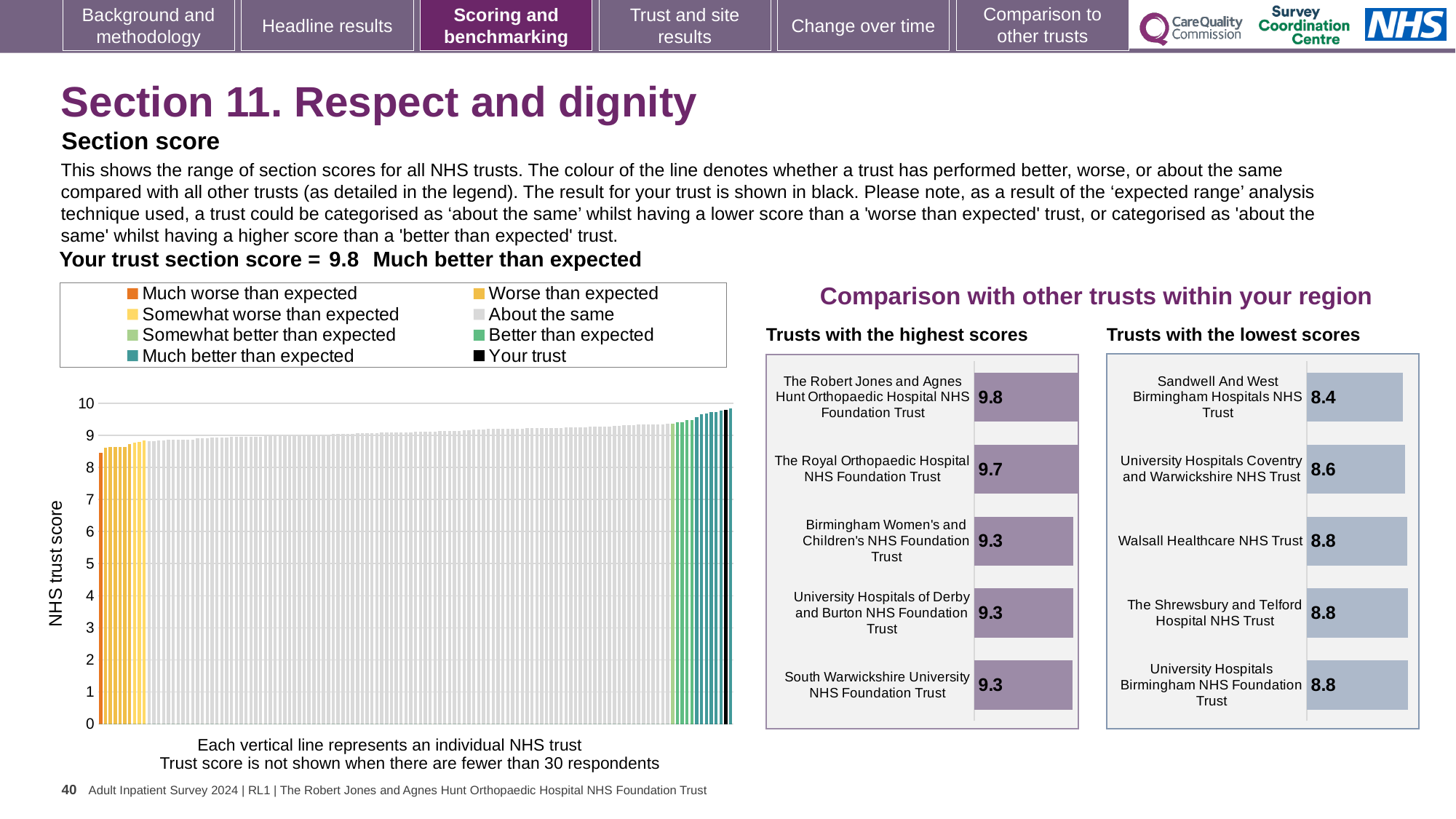
In the 'Trusts with the highest scores' chart, which trust has the highest score? The Robert Jones and Agnes Hunt Orthopaedic Hospital NHS Foundation Trust In the 'Trusts with the highest scores' chart, what is the difference between the scores of The Robert Jones and Agnes Hunt Orthopaedic Hospital NHS Foundation Trust and Birmingham Women's and Children's NHS Foundation Trust? 0.5 In the 'Trusts with the lowest scores' chart, which trust has the lowest score? Sandwell And West Birmingham Hospitals NHS Trust Which has the larger score: The Royal Orthopaedic Hospital NHS Foundation Trust in the highest scores chart or University Hospitals Coventry and Warwickshire NHS Trust in the lowest scores chart? The Royal Orthopaedic Hospital NHS Foundation Trust In the NHS trust score chart on the left, do the bar values rise or fall from left to right? rise In the 'Trusts with the lowest scores' chart, what is the score for Sandwell And West Birmingham Hospitals NHS Trust? 8.4 In the 'Trusts with the lowest scores' chart, how much higher is Walsall Healthcare NHS Trust's score than Sandwell And West Birmingham Hospitals NHS Trust's score? 0.4 How many entries does the legend of the NHS trust score chart list? 8 How many trusts are shown in the 'Trusts with the highest scores' chart? 5 In the NHS trust score chart on the left, is the value for the leftmost bar greater or less than 8? greater In the 'Trusts with the highest scores' chart, what is the score for The Royal Orthopaedic Hospital NHS Foundation Trust? 9.7 What kind of chart is the 'Trusts with the lowest scores' chart? Bar chart